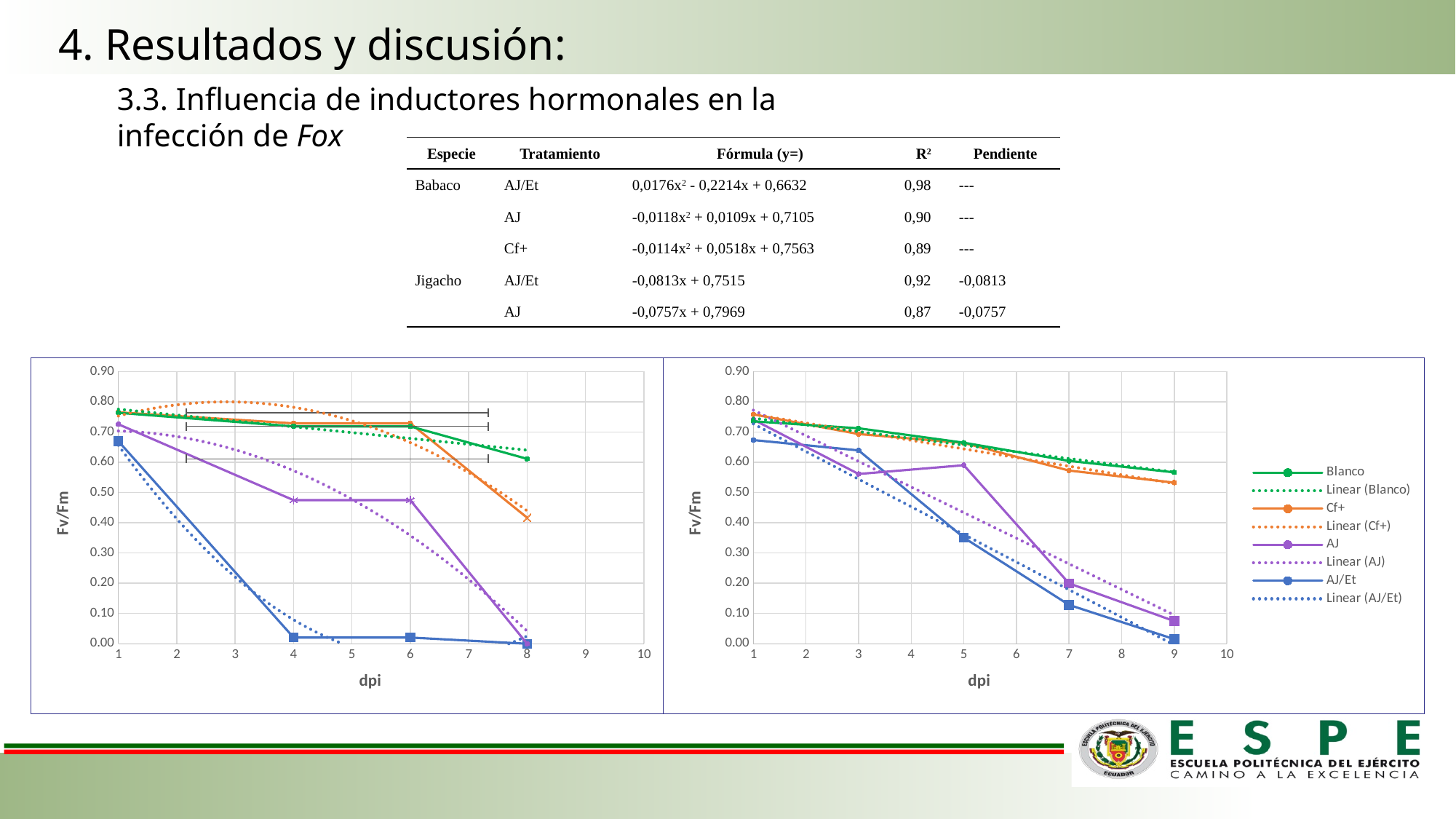
In the left chart, is the value of the blue line at 4 dpi greater or less than 0.10? less In the right chart, how many data points does the solid Blanco line have? 5 In the right chart, which series has the lowest value at 5 dpi? AJ/Et In the right chart, do the AJ/Et values rise or fall as dpi increases? Fall In the right chart, is the AJ/Et value at 9 dpi greater or less than 0.10? less In the right chart, is the Blanco value at 1 dpi greater or less than 0.70? greater What is the label of the vertical axis in both charts? Fv/Fm In the left chart, how many data points does each solid line have? 4 In the right chart, at 9 dpi, which is larger: the Blanco value or the AJ value? Blanco What kind of chart is the chart on the right of the slide? Line chart How many series does the legend of the right chart list? 8